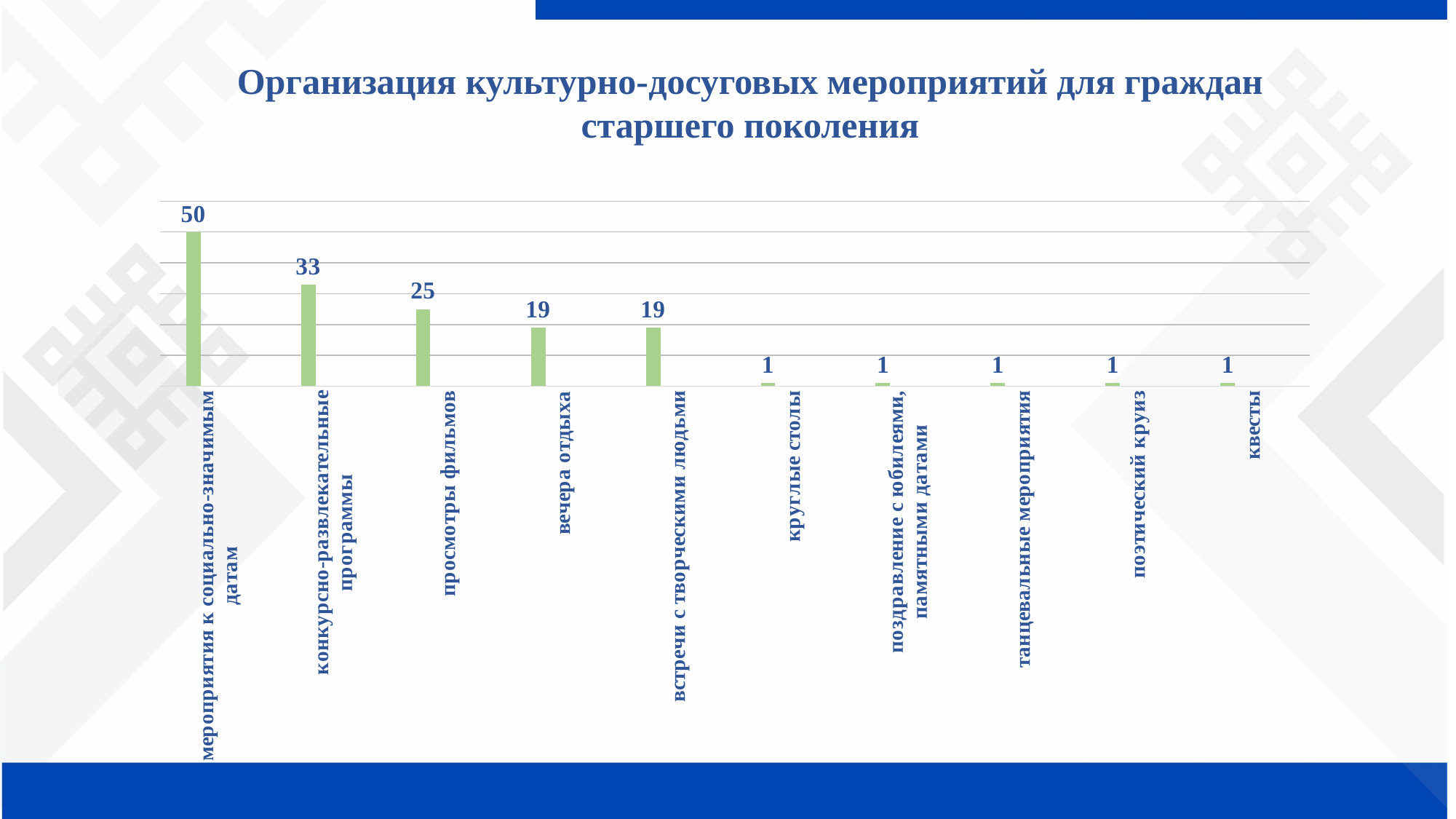
What kind of chart is shown on the slide? bar chart What is the value for "мероприятия к социально-значимым датам"? 50 How many categories are shown in the chart? 10 What is the difference between the values for "мероприятия к социально-значимым датам" and "конкурсно-развлекательные программы"? 17 What is the value for "просмотры фильмов"? 25 What is the value for "конкурсно-развлекательные программы"? 33 What is the value for "квесты"? 1 What is the title of the chart? Организация культурно-досуговых мероприятий для граждан старшего поколения What is the difference between the values for "просмотры фильмов" and "вечера отдыха"? 6 Which is larger, the value for "конкурсно-развлекательные программы" or the value for "просмотры фильмов"? конкурсно-развлекательные программы What is the value for "вечера отдыха"? 19 Which category has the highest value? мероприятия к социально-значимым датам